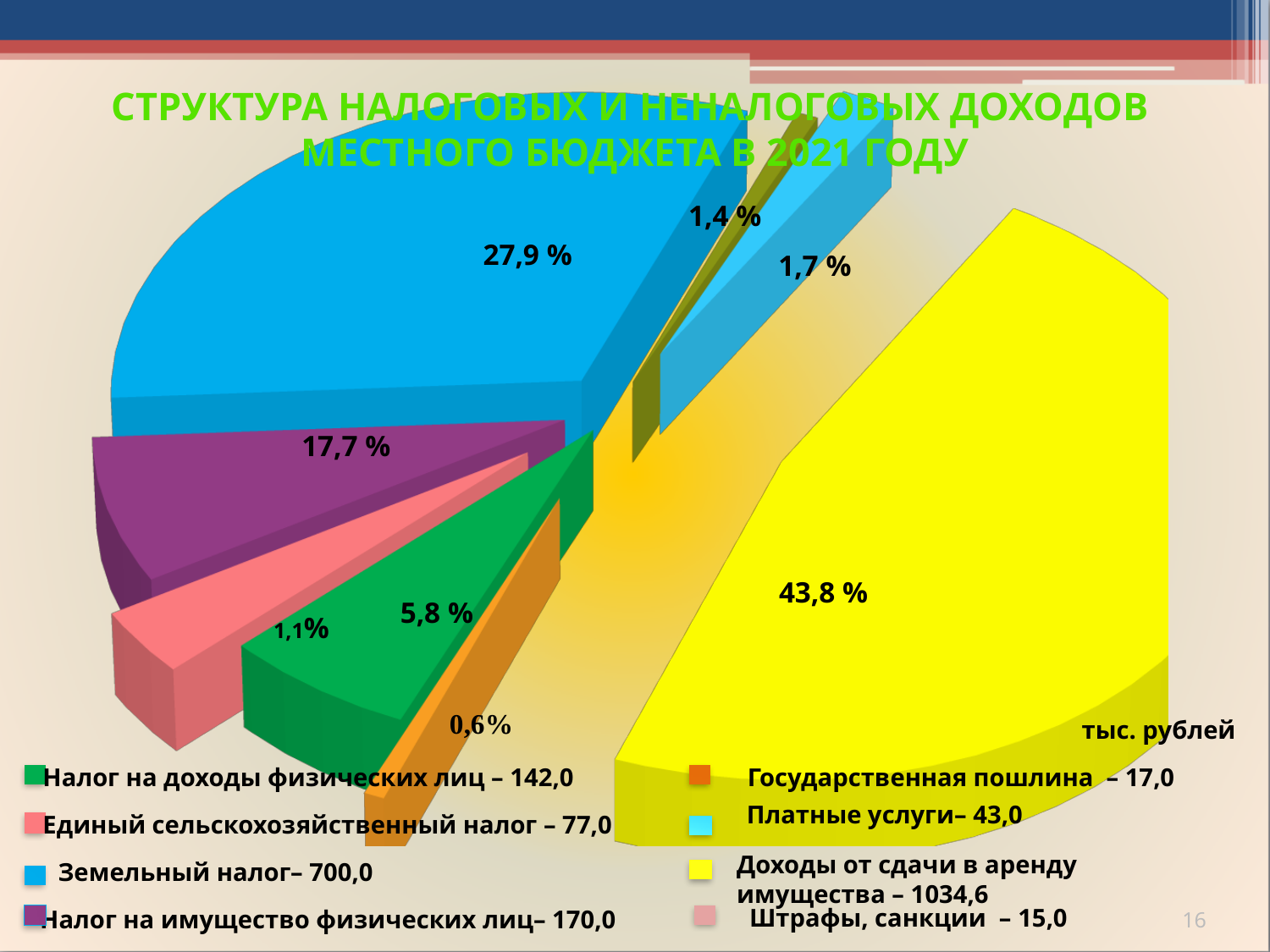
What value does the legend give for Доходы от сдачи в аренду имущества? 1034,6 What percentage is shown on the blue slice (Земельный налог)? 27,9 % How many categories does the legend list? 8 What value does the legend give for Земельный налог? 700,0 What percentage is shown on the green slice (Налог на доходы физических лиц)? 5,8 % What percentage is shown on the purple slice (Налог на имущество физических лиц)? 17,7 % In what unit are the legend values given? тыс. рублей Which category has the largest share of the pie? Доходы от сдачи в аренду имущества Which is larger according to the legend: Налог на доходы физических лиц or Налог на имущество физических лиц? Налог на имущество физических лиц What kind of chart is shown on the slide? pie chart What value does the legend give for Государственная пошлина? 17,0